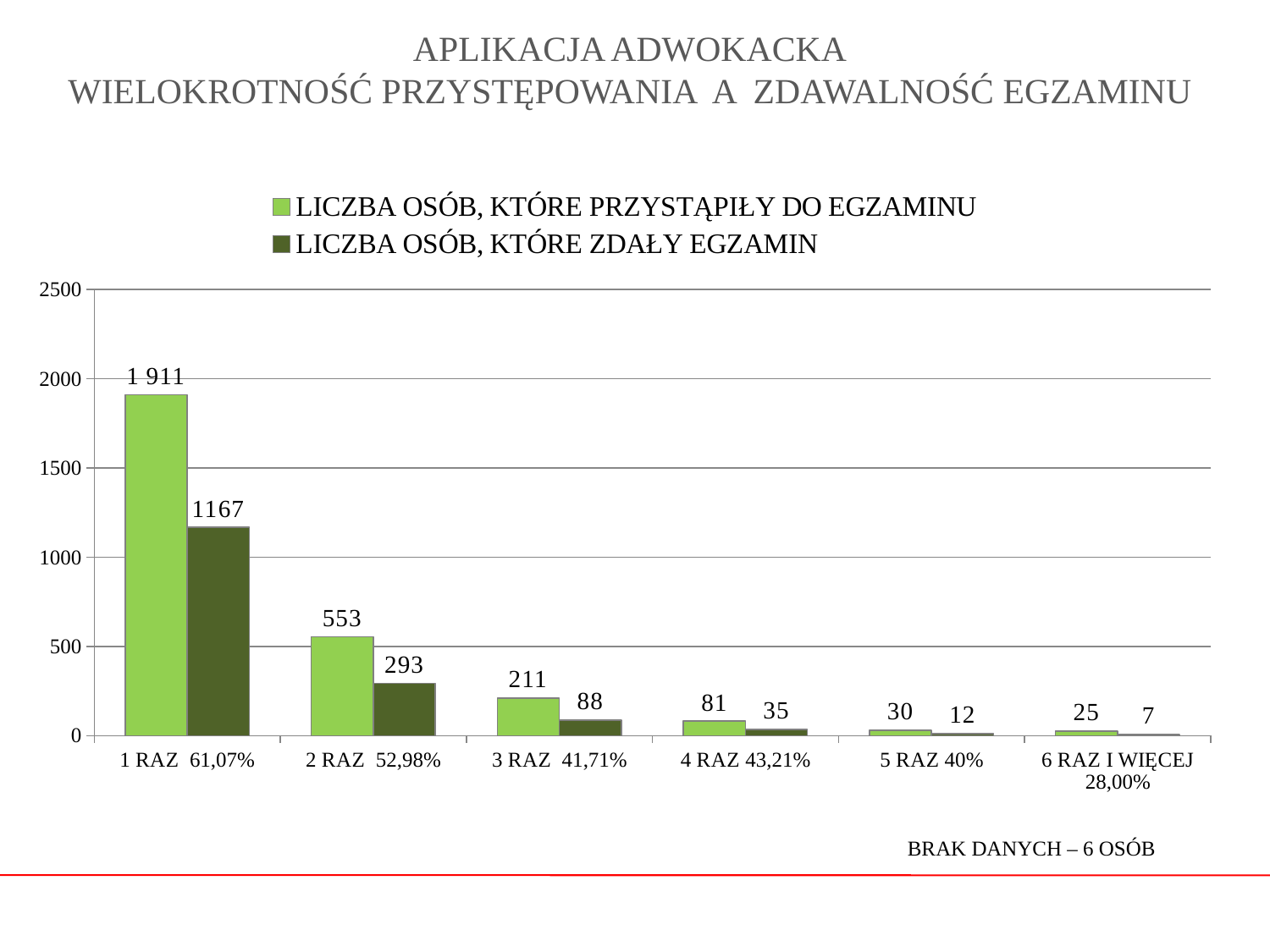
How many people took the exam for the first time (1 RAZ) according to the chart? 1 911 How many people passed the exam in the 6 RAZ I WIĘCEJ category? 7 What kind of chart is shown on the slide? Bar chart What is the number of people who took the exam in the 3 RAZ category? 211 How many series does the legend list? 2 Which category has the highest number of people who took the exam? 1 RAZ How many categories are shown on the x axis of the chart? 6 How many people passed the exam in the 2 RAZ category? 293 Which is larger: the number of people who passed in the 4 RAZ category or the number who took the exam in the 5 RAZ category? 4 RAZ passed (35) Which category has the lowest number of people who passed the exam? 6 RAZ I WIĘCEJ What is the difference between the number of people who took the exam and the number who passed in the 1 RAZ category? 744 What is the difference between the number of people who took the exam in the 2 RAZ category and in the 3 RAZ category? 342